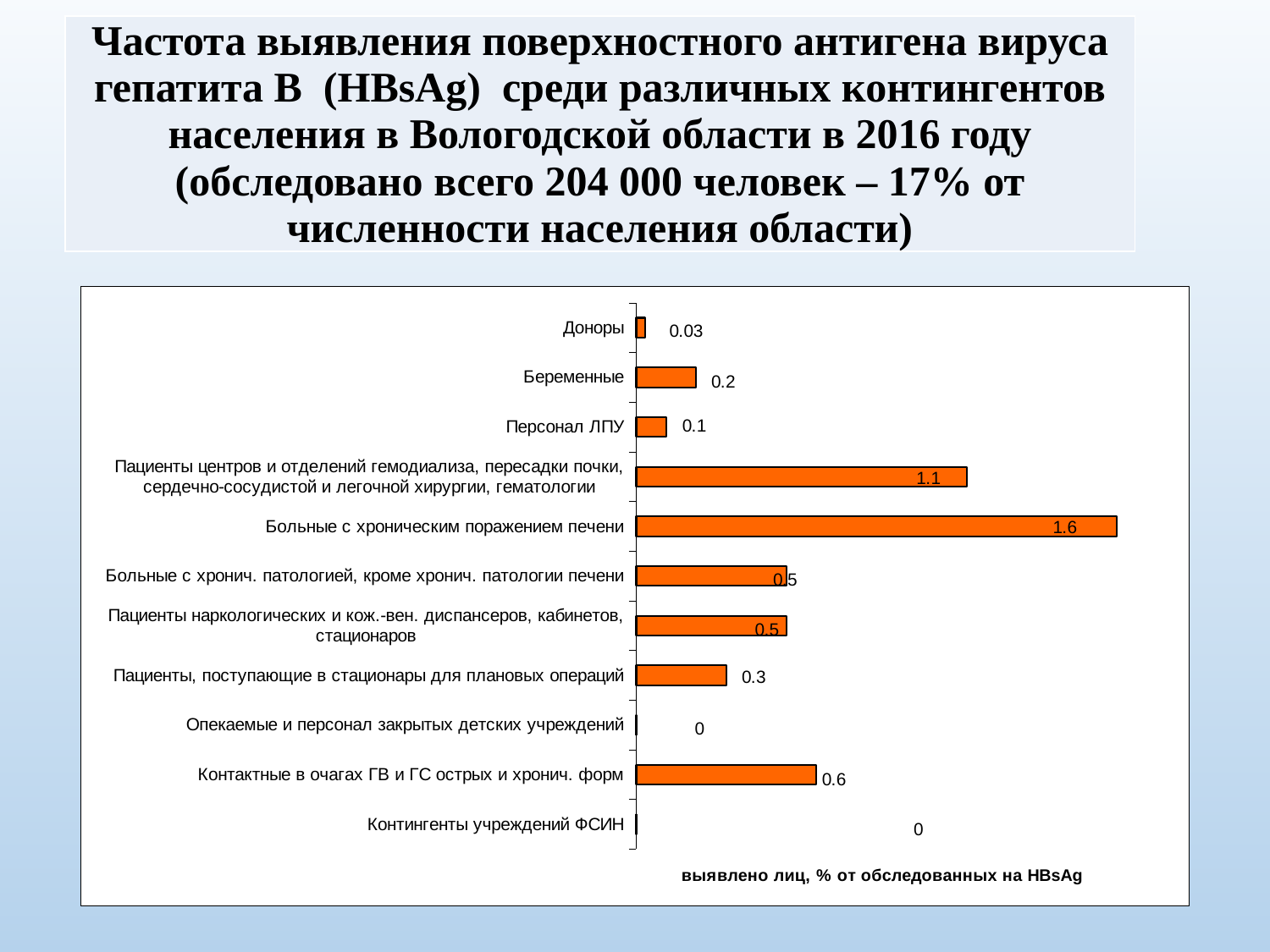
Which category has the highest value in the chart? Больные с хроническим поражением печени What is the value for Беременные? 0.2 What type of chart is shown on the slide? bar chart Which is larger: the value for Беременные or the value for Персонал ЛПУ? Беременные What is the value for Контингенты учреждений ФСИН? 0 What is the value for Больные с хроническим поражением печени? 1.6 What is the label of the horizontal axis of the chart? выявлено лиц, % от обследованных на HBsAg How many categories (population groups) are plotted in the chart? 11 What is the value for Пациенты, поступающие в стационары для плановых операций? 0.3 What is the value for Контактные в очагах ГВ и ГС острых и хронич. форм? 0.6 What is the value for Доноры? 0.03 What is the difference between the values for Больные с хроническим поражением печени and Пациенты центров и отделений гемодиализа, пересадки почки, сердечно-сосудистой и легочной хирургии, гематологии? 0.5